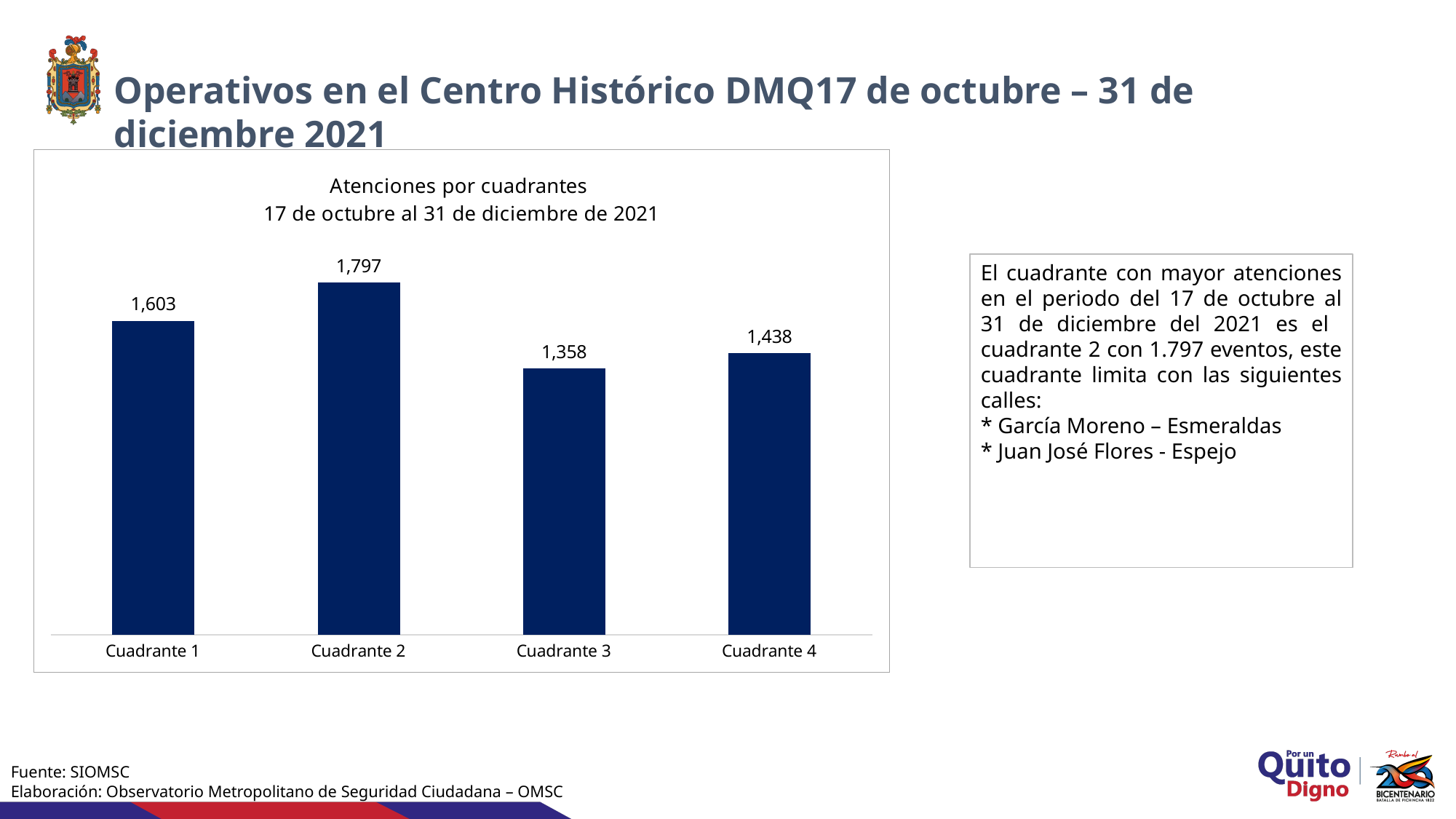
Which is larger, the value for Cuadrante 1 or the value for Cuadrante 4? Cuadrante 1 What is the value for Cuadrante 1? 1,603 What is the difference between the values for Cuadrante 2 and Cuadrante 3? 439 Which cuadrante has the lowest number of atenciones? Cuadrante 3 What is the title of the chart? Atenciones por cuadrantes 17 de octubre al 31 de diciembre de 2021 What is the difference between the values for Cuadrante 1 and Cuadrante 4? 165 What is the value for Cuadrante 2? 1,797 What kind of chart is shown on the slide? Bar chart Which cuadrante has the highest number of atenciones? Cuadrante 2 What is the value for Cuadrante 3? 1,358 How many cuadrantes are shown in the chart? 4 What is the value for Cuadrante 4? 1,438